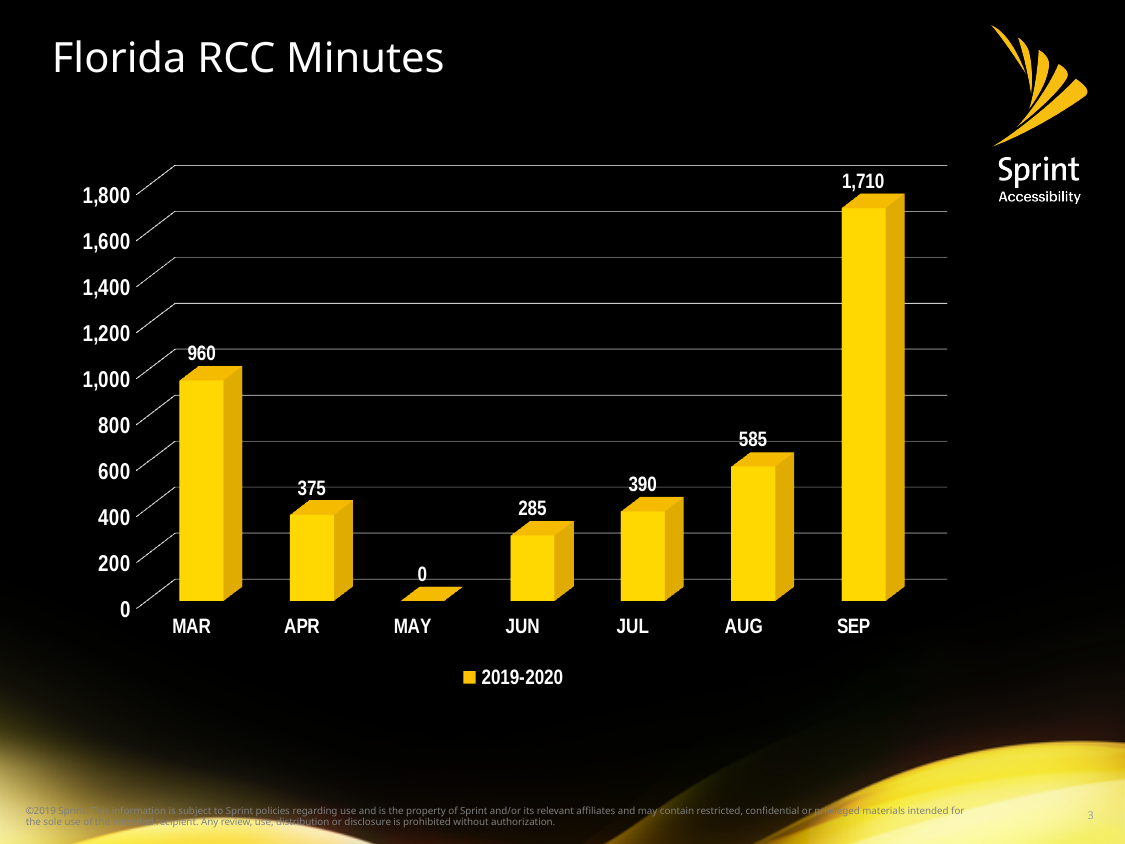
What is the value for MAR? 960 How many series does the legend list? 1 Which is larger, the value for APR or the value for JUN? APR What is the difference between the values for AUG and JUL? 195 What kind of chart is shown? bar chart What is the value for MAY? 0 Which month has the highest value? SEP Which month has the lowest value? MAY What is the title of the chart? Florida RCC Minutes How many months are shown on the x axis? 7 What is the value for SEP? 1,710 What is the difference between the values for SEP and MAR? 750